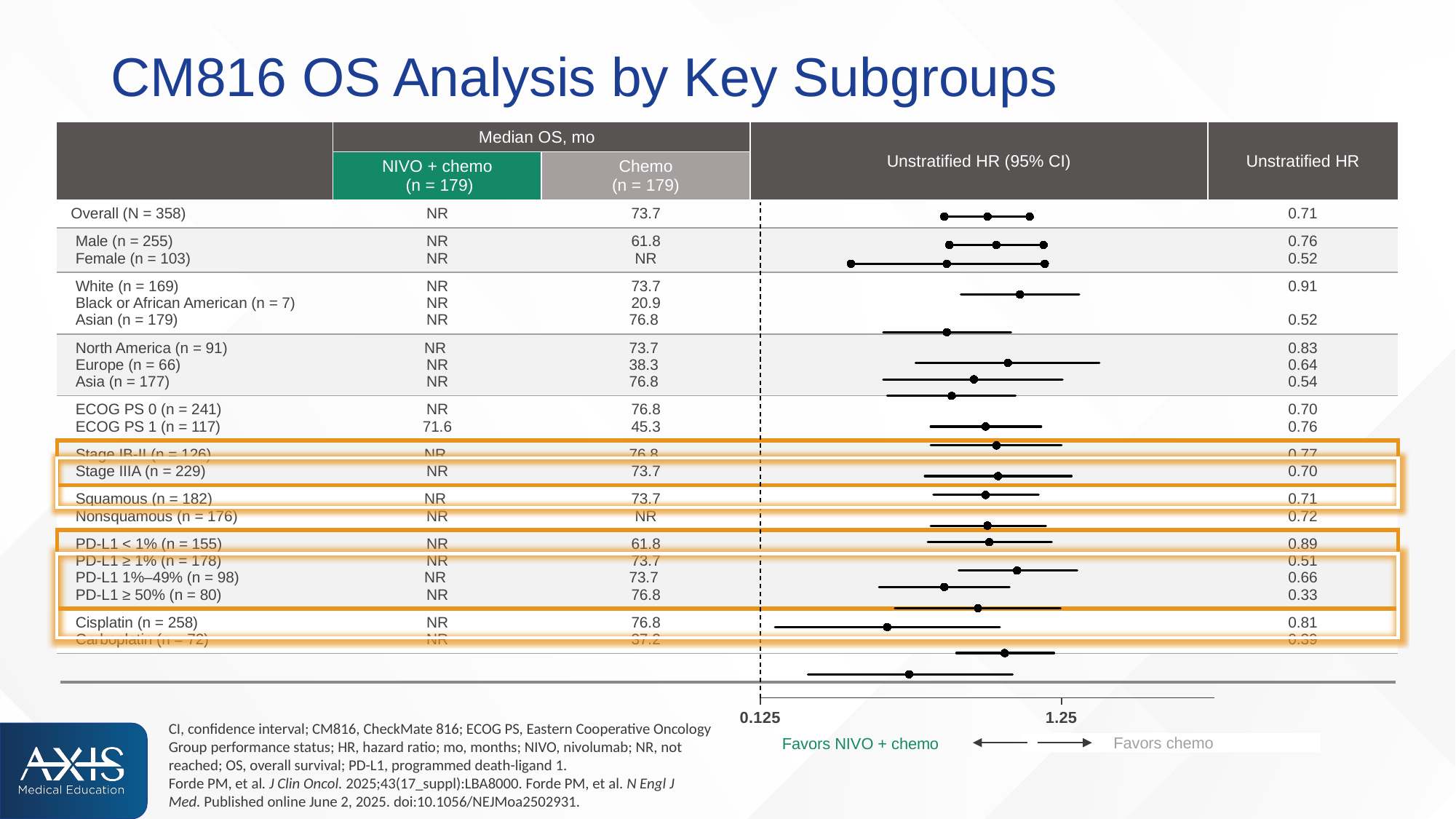
What is the unstratified HR for the PD-L1 ≥ 50% (n = 80) subgroup? 0.33 What is the difference between the unstratified HR for White (n = 169) and Asian (n = 179)? 0.39 Which direction on the forest plot axis favors NIVO + chemo? Left What is the median OS in months for the Chemo arm in the Europe (n = 66) subgroup? 38.3 What are the two tick values labeled on the x axis of the forest plot? 0.125 and 1.25 What is the median OS in months for the NIVO + chemo arm in the ECOG PS 1 (n = 117) subgroup? 71.6 What is the unstratified HR for the Female (n = 103) subgroup? 0.52 Which subgroup has the lowest unstratified HR shown, PD-L1 ≥ 50% or PD-L1 < 1%? PD-L1 ≥ 50% What kind of chart is shown in the Unstratified HR (95% CI) column? Forest plot Which subgroup has the higher unstratified HR, Male (n = 255) or Female (n = 103)? Male (n = 255) What is the median OS in months for the Chemo arm in the Black or African American (n = 7) subgroup? 20.9 What is the unstratified HR for the Overall (N = 358) group? 0.71